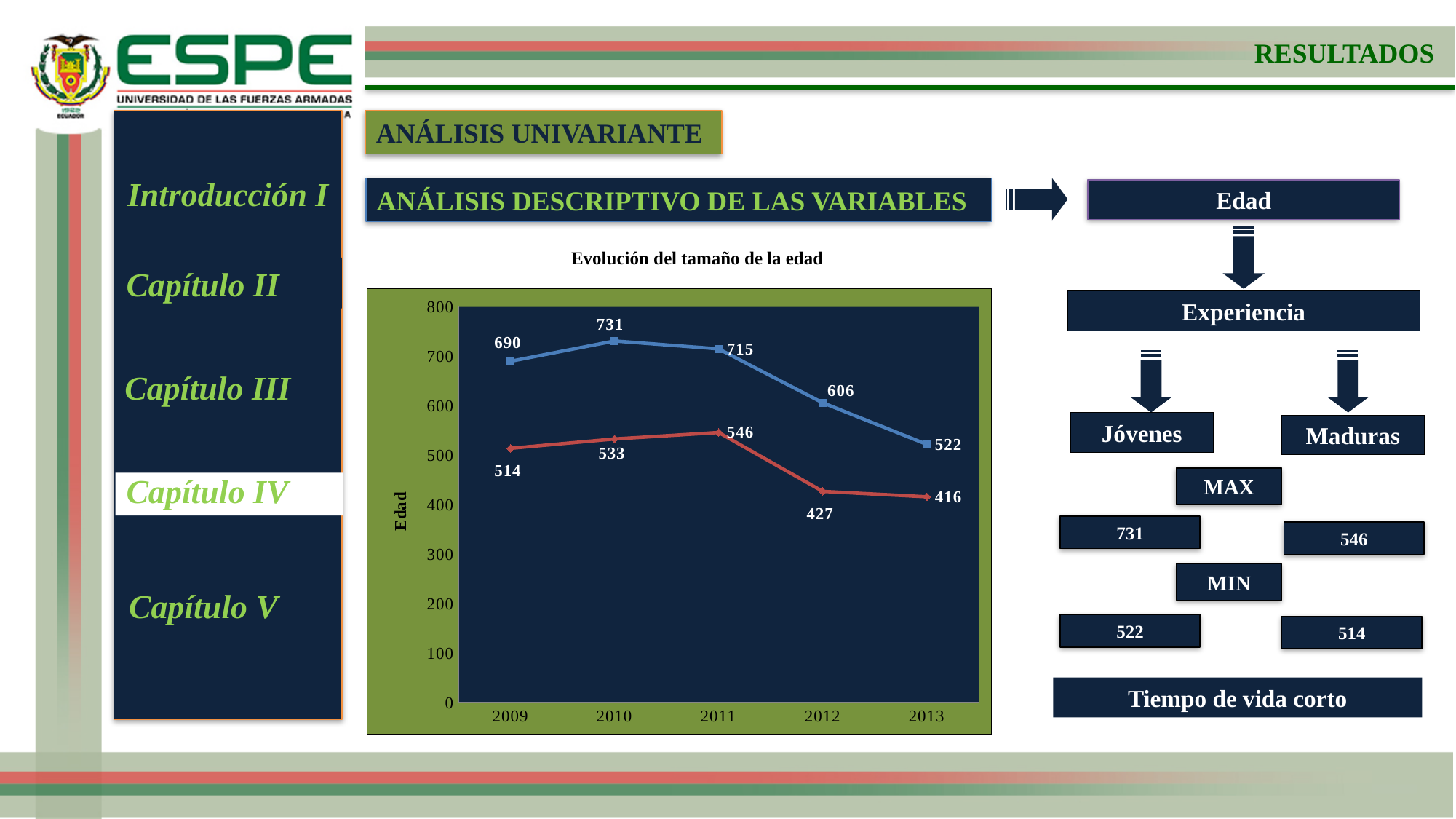
What is the value of the blue line in 2010? 731 What type of chart is shown on the slide? line chart What is the title of the chart? Evolución del tamaño de la edad What is the value of the blue line in 2013? 522 Does the blue line rise or fall between 2011 and 2013? fall What is the difference between the blue line and the red line in 2009? 176 In which year does the blue line reach its highest value? 2010 What is the label of the y axis? Edad How many years are shown on the x axis? 5 Which is larger, the red line's value in 2011 or its value in 2010? 2011 In which year does the red line reach its lowest value? 2013 What is the value of the red line in 2012? 427